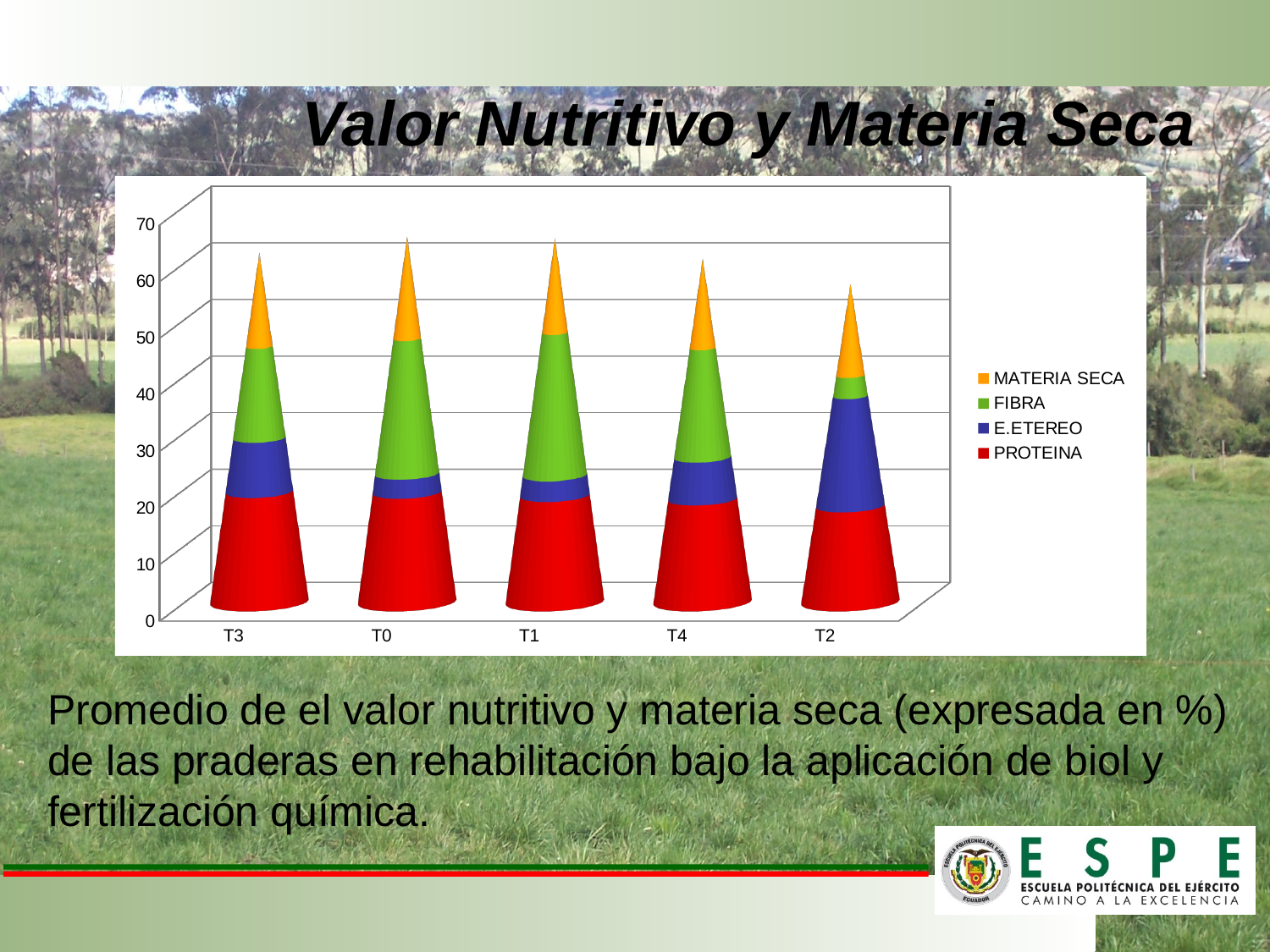
What kind of chart is shown on the slide? bar chart Is the PROTEINA value for T3 greater or less than 30? less How many categories are shown on the x axis of the chart? 5 Which series is shown in red in the chart? PROTEINA How many series does the chart legend list? 4 What is the title of the chart on the slide? Valor Nutritivo y Materia Seca Is the total stacked value for T3 greater or less than 50? greater Is the total stacked value for T0 greater or less than 60? greater Which category has the larger E.ETEREO segment, T2 or T0? T2 Which category has the larger FIBRA segment, T1 or T2? T1 Which category has the lowest total stacked value in the chart? T2